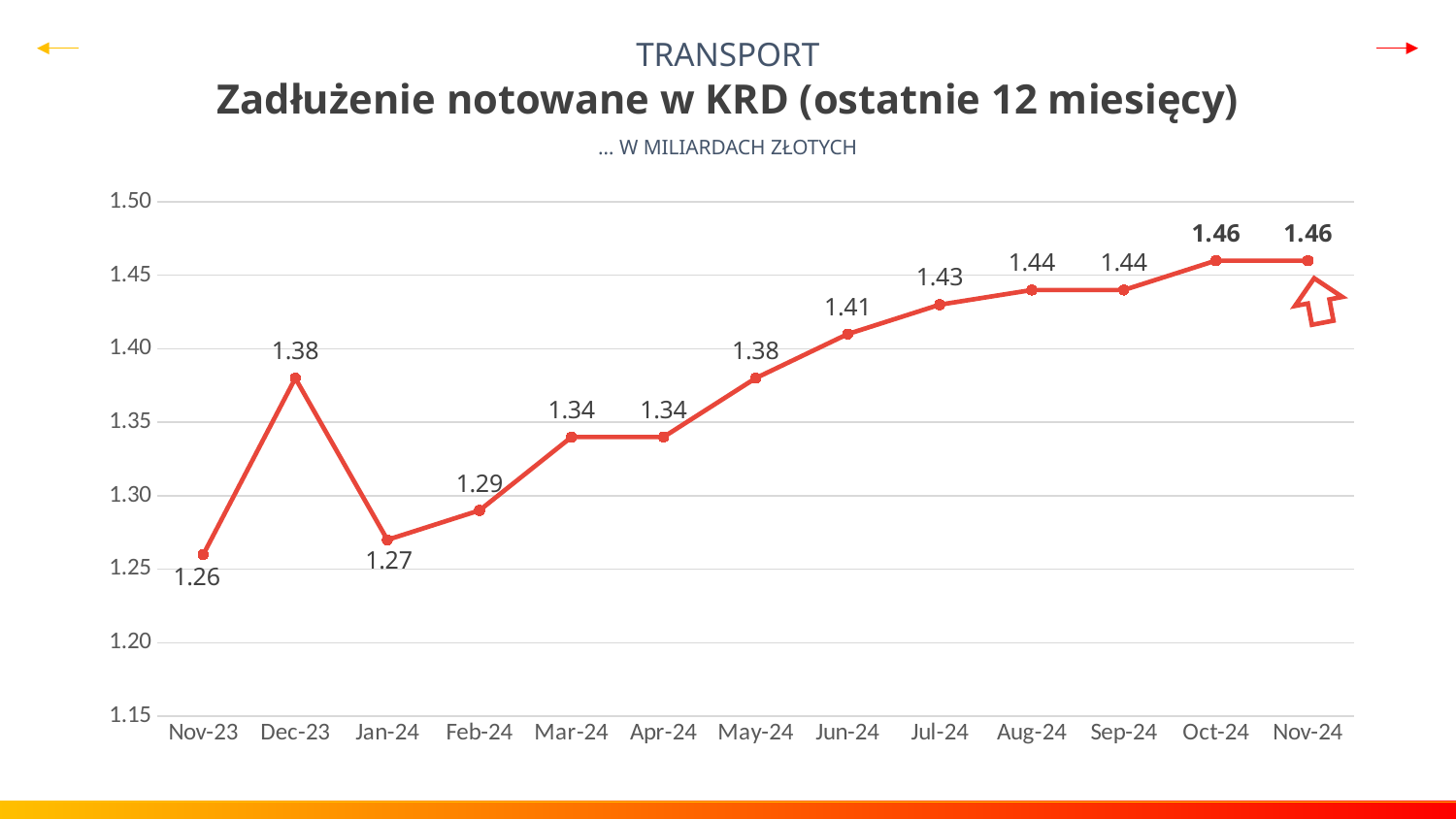
Is the value for Jun-24 greater or less than 1.40? greater What is the difference between the values for Nov-24 and Nov-23? 0.20 Which month has the lowest value? Nov-23 Which is larger, the value for Dec-23 or the value for Feb-24? Dec-23 What kind of chart is shown on the slide? line chart What is the difference between the values for Dec-23 and Jan-24? 0.11 Do the values generally rise or fall from Jan-24 to Nov-24? rise What is the value for Jul-24? 1.43 What is the value for Dec-23? 1.38 What is the value for Nov-23? 1.26 How many data points are plotted on the chart? 13 What is the value for Nov-24? 1.46